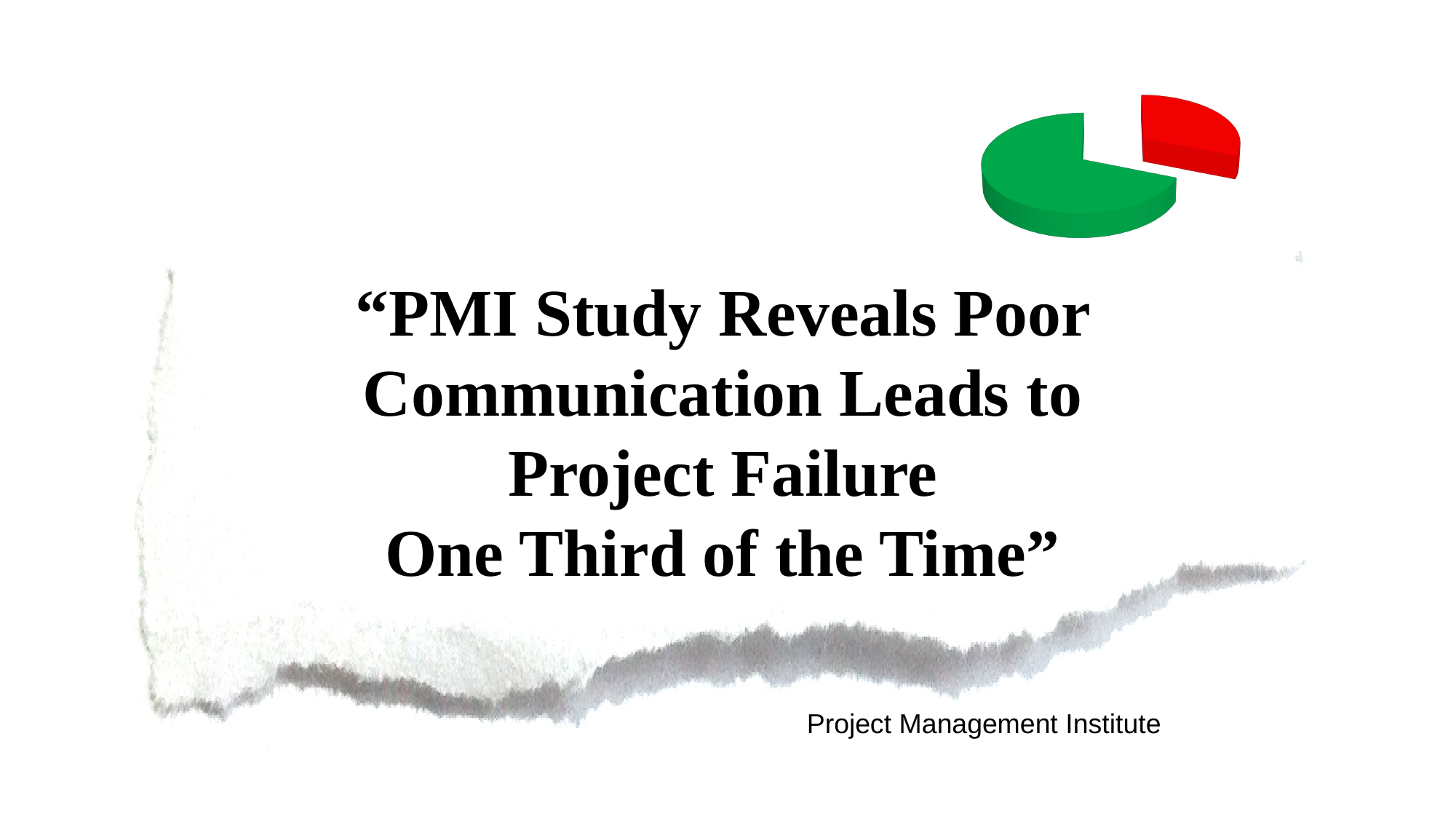
Which slice of the pie chart is larger, the green one or the red one? the green one What kind of chart is shown in the top right of the slide? pie chart Which slice of the pie chart is the smallest? the red slice Which slice of the pie chart is the largest? the green slice How many slices does the pie chart have? 2 Does the pie chart have a legend? No What two colours are used for the slices of the pie chart? green and red